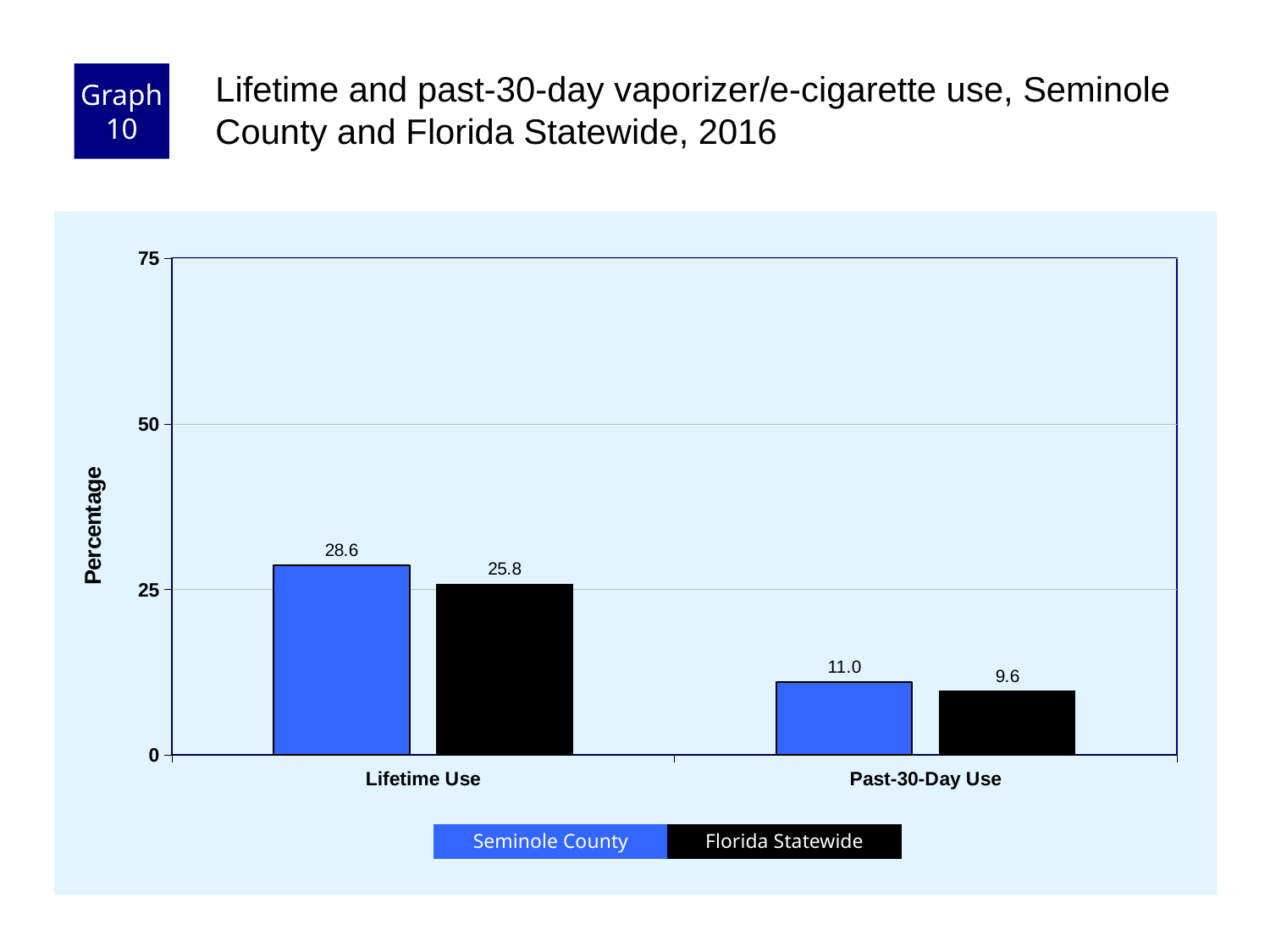
What is the Florida Statewide value for Lifetime Use? 25.8 How many series does the legend list? 2 What is the Seminole County value for Past-30-Day Use? 11.0 What is the Seminole County value for Lifetime Use? 28.6 What kind of chart is shown on the slide? Bar chart What is the difference between the Seminole County and Florida Statewide values for Lifetime Use? 2.8 What is the Florida Statewide value for Past-30-Day Use? 9.6 What is the difference between the Seminole County and Florida Statewide values for Past-30-Day Use? 1.4 For Past-30-Day Use, which is larger: Seminole County or Florida Statewide? Seminole County How many categories are shown on the x axis? 2 Which bar has the highest value on the chart? Seminole County, Lifetime Use Which bar has the lowest value on the chart? Florida Statewide, Past-30-Day Use